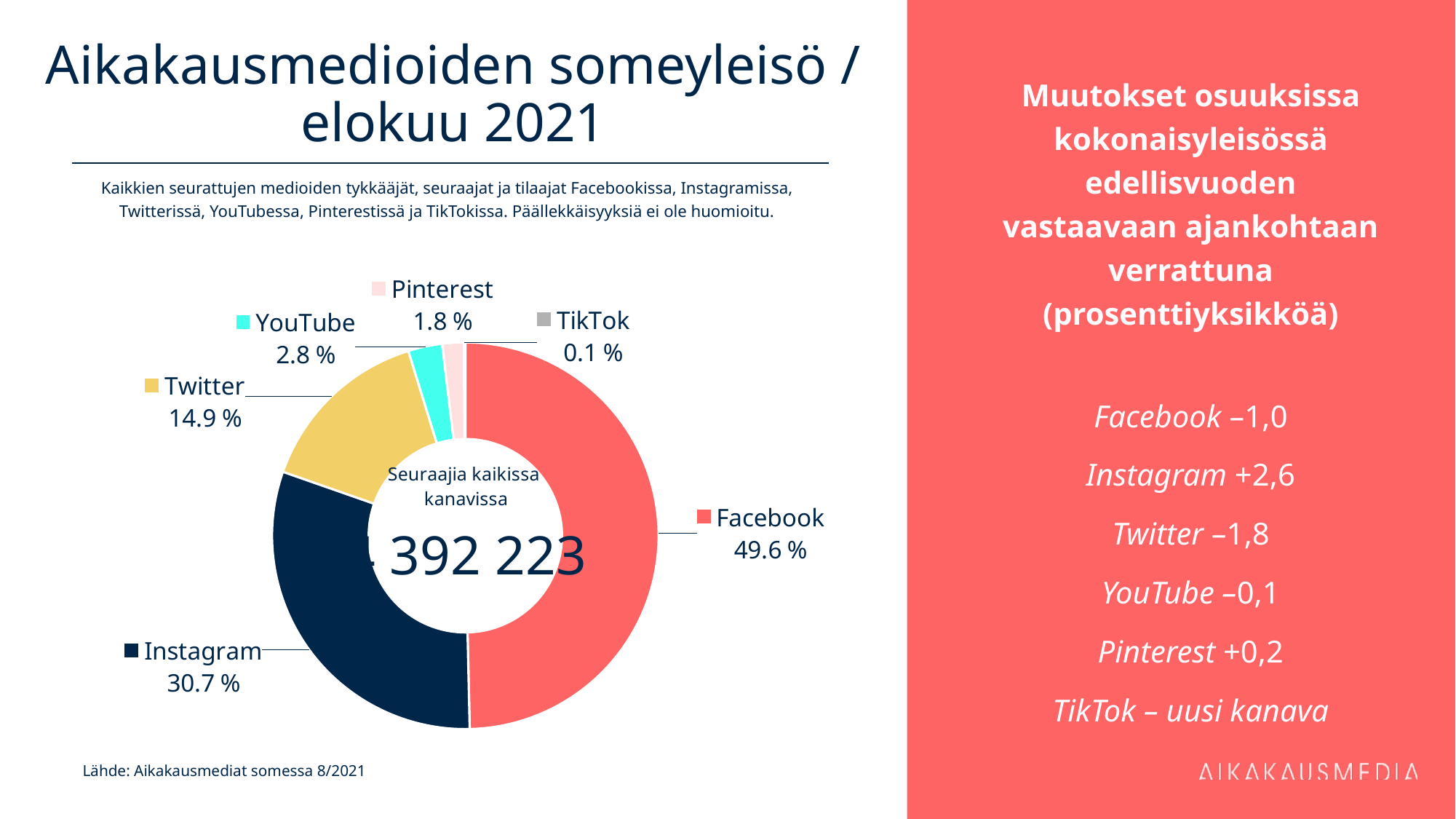
What share of the social media audience does Facebook have? 49.6 % What share of the social media audience does Instagram have? 30.7 % How many channels are shown in the chart? 6 What colour is the Twitter slice in the chart? Yellow What share of the social media audience does Twitter have? 14.9 % Which has a larger share, Twitter or YouTube? Twitter What is the difference in percentage points between Facebook's and Instagram's shares? 18.9 What share of the social media audience does Pinterest have? 1.8 % Which channel has the smallest share of the audience? TikTok Which channel has the largest share of the audience? Facebook What share of the social media audience does YouTube have? 2.8 % What type of chart is shown on the slide? Pie chart (donut)